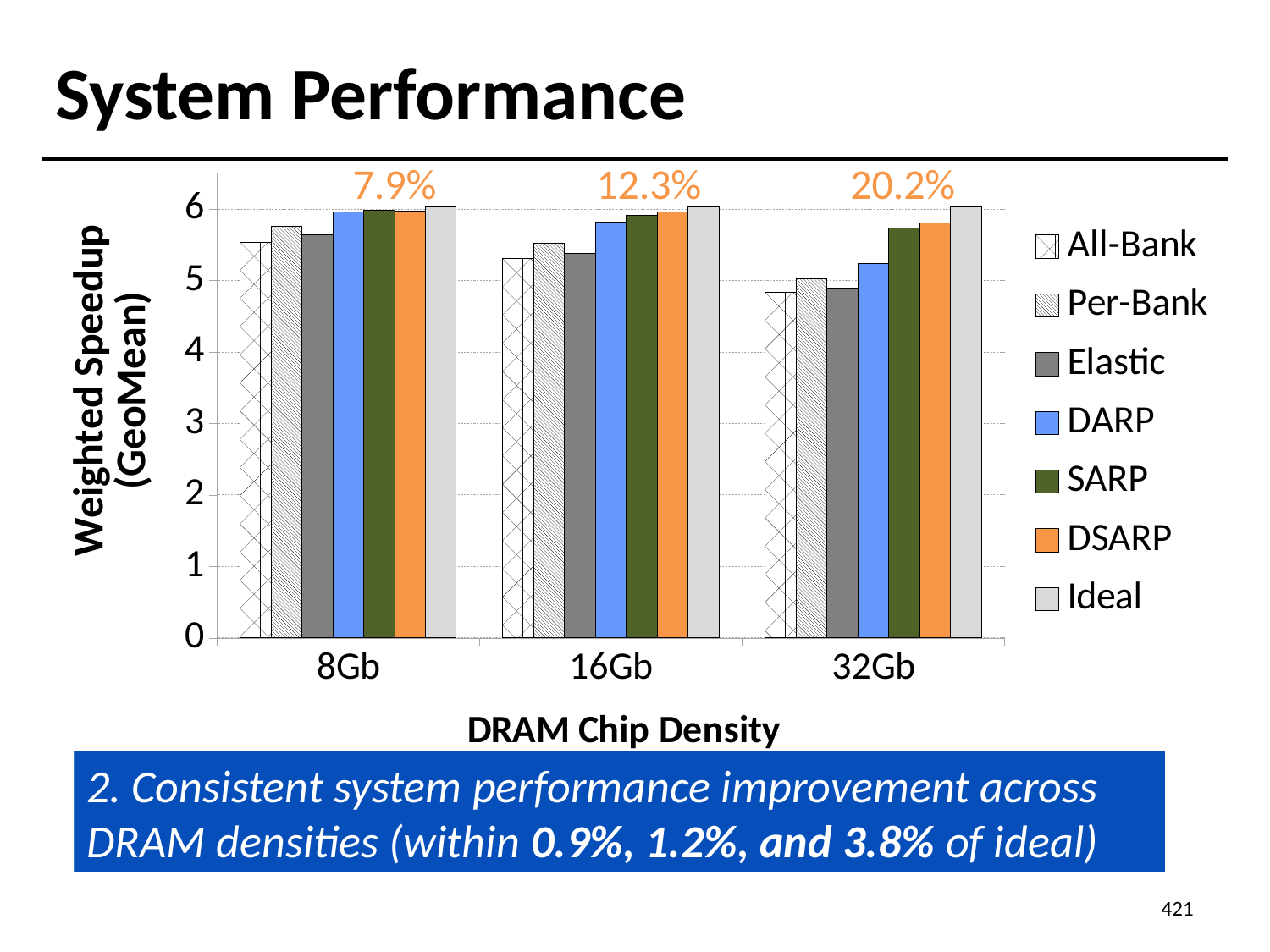
What is the label of the y axis? Weighted Speedup (GeoMean) What percentage is printed above the 16Gb group of bars? 12.3% Which series has the lowest value at 32Gb? All-Bank How many DRAM chip density categories are shown on the x axis? 3 Do the All-Bank values rise or fall as DRAM chip density increases from 8Gb to 32Gb? fall How many series does the legend list? 7 What kind of chart is shown on the slide? bar chart Is the All-Bank value at 8Gb greater or less than 5? greater What percentage is printed above the 32Gb group of bars? 20.2% What percentage is printed above the 8Gb group of bars? 7.9% Is the All-Bank value at 32Gb greater or less than 5? less Which series has the highest value at 32Gb? Ideal